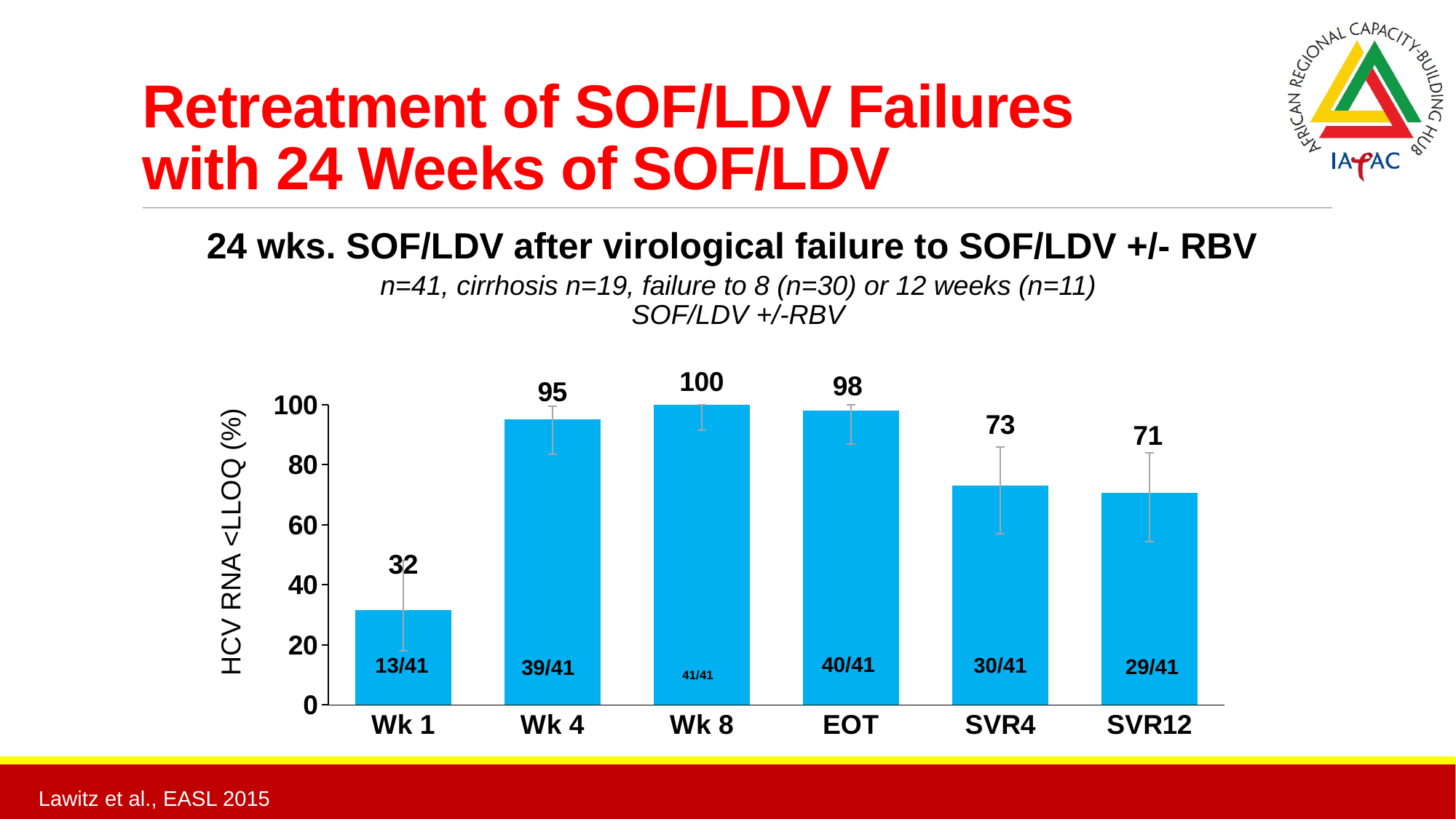
Which category has the highest value? Wk 8 What is the difference between the values for Wk 4 and Wk 1? 63 What is the difference between the values for Wk 8 and SVR12? 29 What is the value for SVR12? 71 What fraction of patients is labelled inside the SVR12 bar? 29/41 Which is larger, the value for SVR4 or the value for SVR12? SVR4 Is the value for SVR4 greater or less than 80? less How many categories are shown on the x axis? 6 What is the value for Wk 1? 32 What is the value for EOT? 98 Which category has the lowest value? Wk 1 What kind of chart is shown on the slide? bar chart